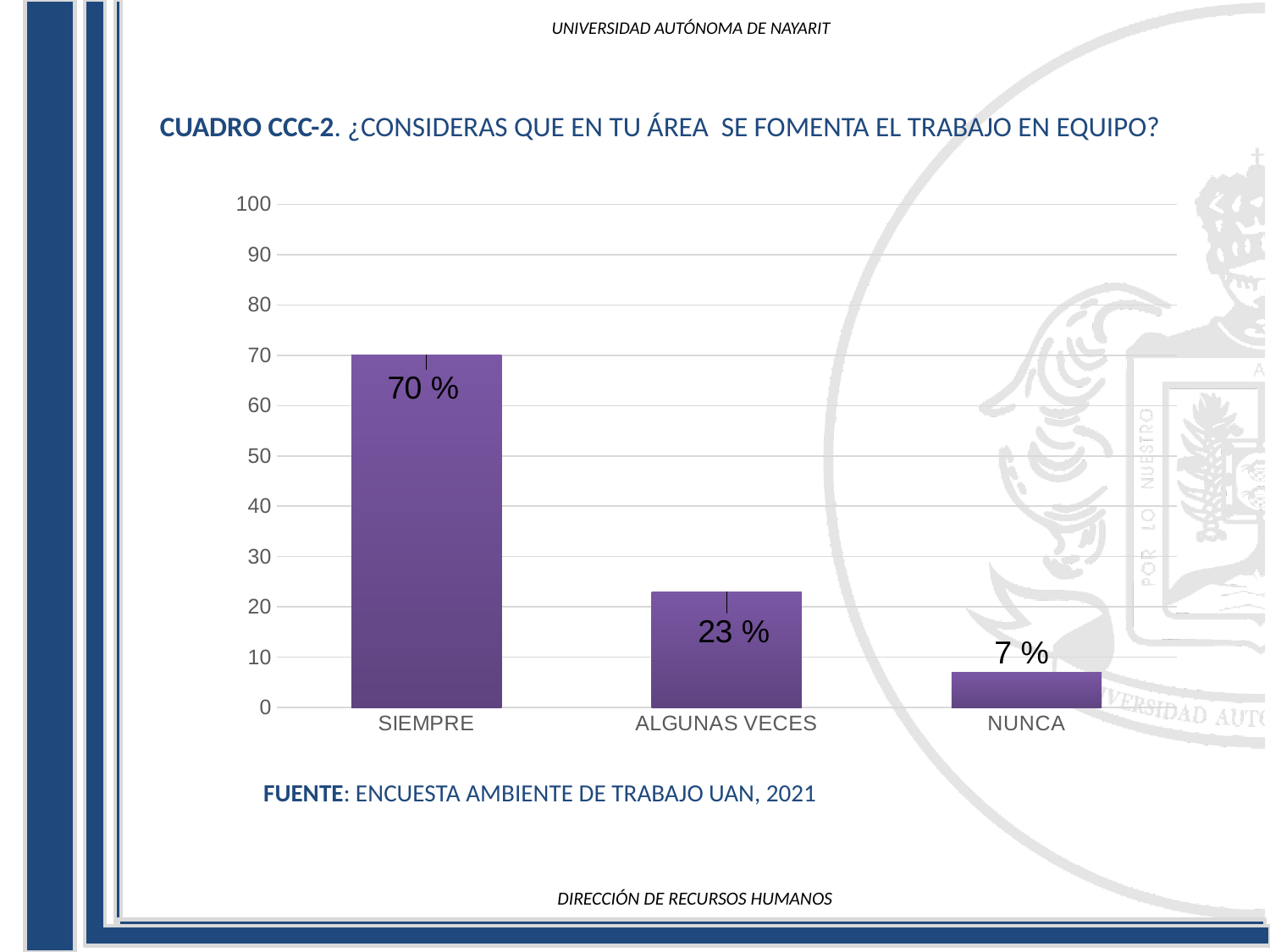
What kind of chart is shown on the slide? bar chart Which category has the highest value? SIEMPRE How many categories are shown on the x axis? 3 What is the difference between the values for ALGUNAS VECES and NUNCA? 16 % Which category has the lowest value? NUNCA Is the value for SIEMPRE greater or less than 60? greater What is the value for NUNCA? 7 % What is the value for ALGUNAS VECES? 23 % Do the values rise or fall from left to right along the x axis? fall Which is larger, the value for ALGUNAS VECES or the value for NUNCA? ALGUNAS VECES What is the value for SIEMPRE? 70 % What is the difference between the values for SIEMPRE and ALGUNAS VECES? 47 %